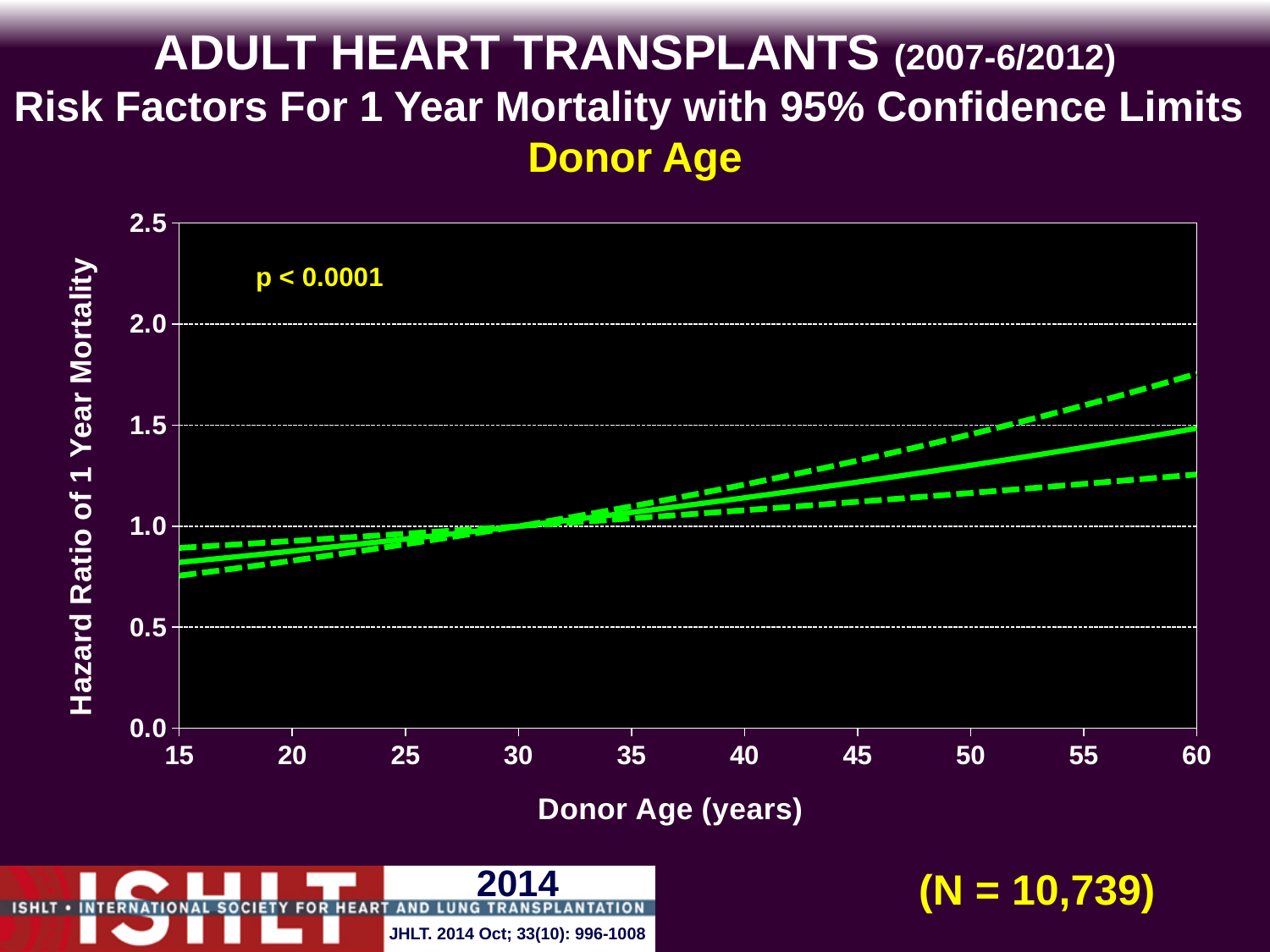
Is the upper dashed confidence limit at a donor age of 60 years greater or less than 1.5? greater What is the sample size N shown on the slide? N = 10,739 Is the hazard ratio on the solid line at a donor age of 40 years greater or less than 1.0? greater Is the hazard ratio on the solid line at a donor age of 60 years greater or less than 1.0? greater How many labelled tick marks are on the x axis of the chart? 10 How many lines are plotted on the chart? 3 As donor age increases along the x axis, does the hazard ratio of 1 year mortality rise or fall? rise What kind of chart is shown on the slide? line chart What p-value is printed on the chart? p < 0.0001